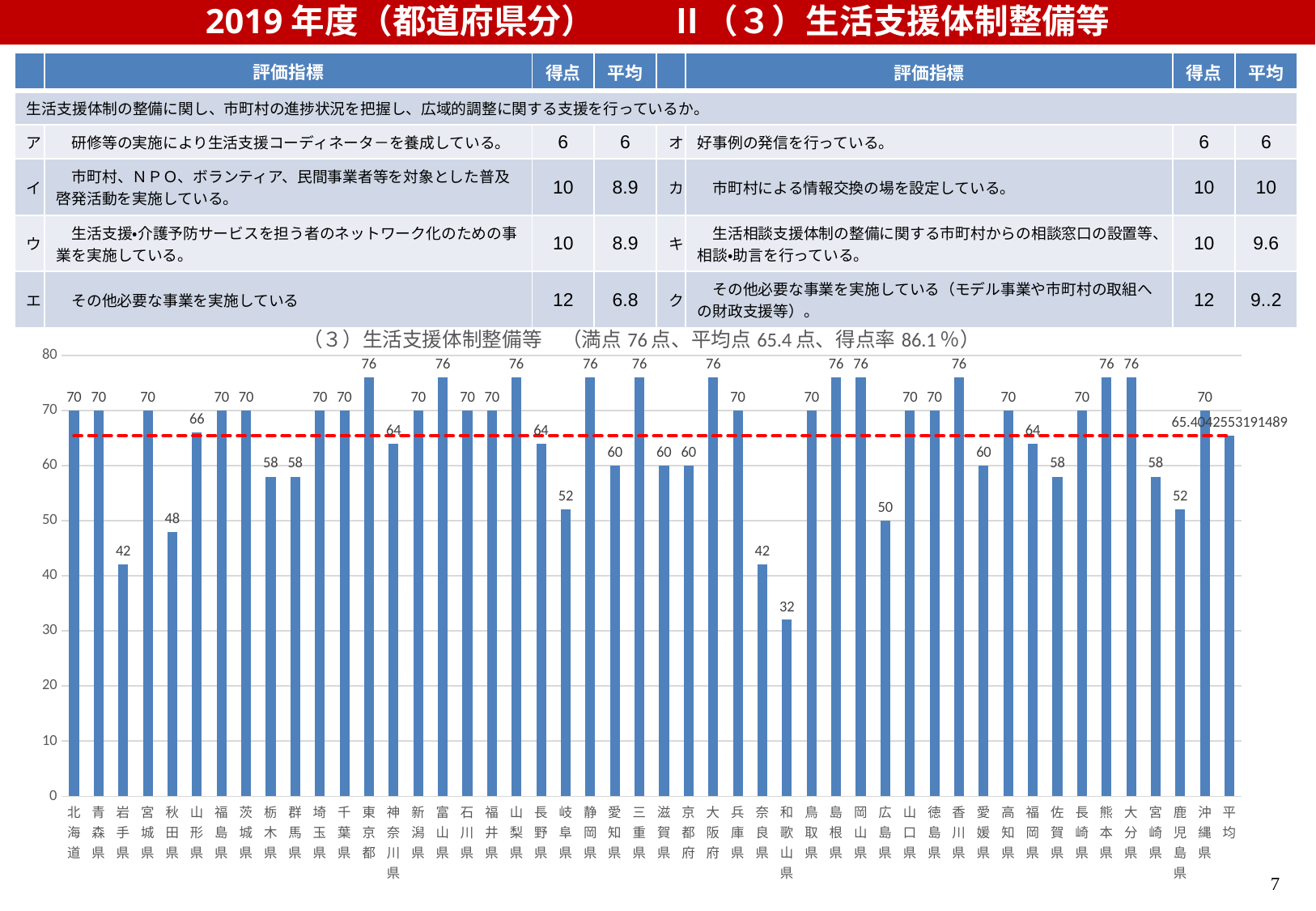
What is the value shown for 平均 at the right end of the bar chart? 65.4042553191489 What is the difference between the values for 奈良県 and 和歌山県? 10 What is the difference between the values for 東京都 and 神奈川県? 12 What is the value for 和歌山県 in the bar chart? 32 What is the value for 岩手県 in the bar chart? 42 According to the chart title, what is the 満点 (maximum score)? 76点 What kind of chart is shown on the slide? bar chart Which has the larger value, 秋田県 or 山形県? 山形県 What is the value for 広島県 in the bar chart? 50 Which prefecture has the lowest value in the bar chart? 和歌山県 Which has the larger value, 岐阜県 or 愛知県? 愛知県 How many bars are plotted in the chart, including 平均? 48